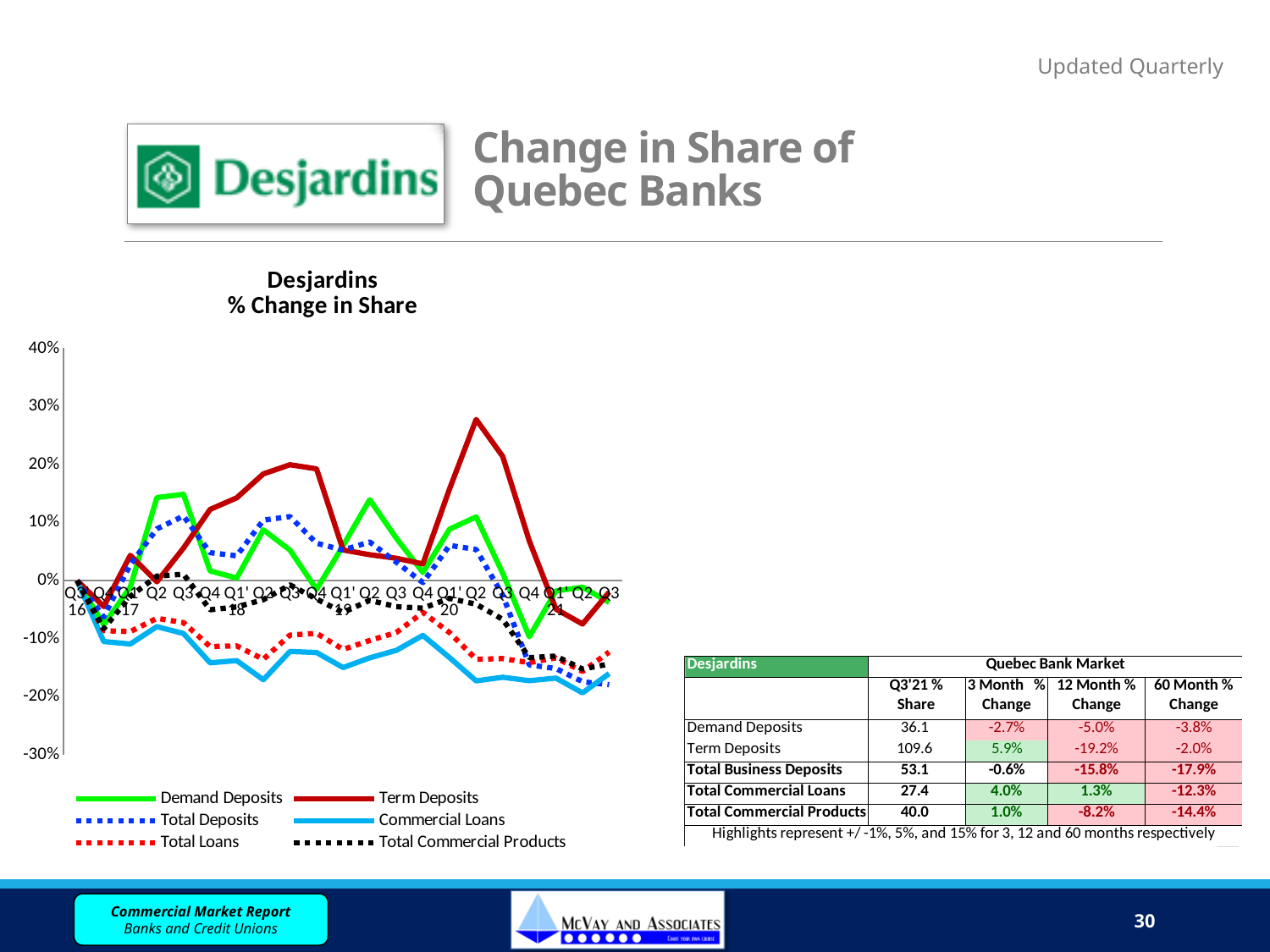
Does the Commercial Loans line generally rise or fall from Q3'16 to Q3'21? Fall What is the highest value shown on the vertical axis of the chart? 40% What colour is the Demand Deposits line in the chart? Green What is the title of the chart on the slide? Desjardins % Change in Share Is the peak value of the Term Deposits line greater or less than 20%? greater What kind of chart is shown on the slide? Line chart How many series does the legend of the Desjardins % Change in Share chart list? 6 At Q2'20, which is larger: the Term Deposits value or the Commercial Loans value? Term Deposits Is the value of the Demand Deposits line at Q2'17 greater or less than 10%? greater Is the value of the Commercial Loans line at Q3'18 greater or less than -10%? less Which series reaches the highest value anywhere on the chart? Term Deposits Which series reaches the lowest value anywhere on the chart? Commercial Loans